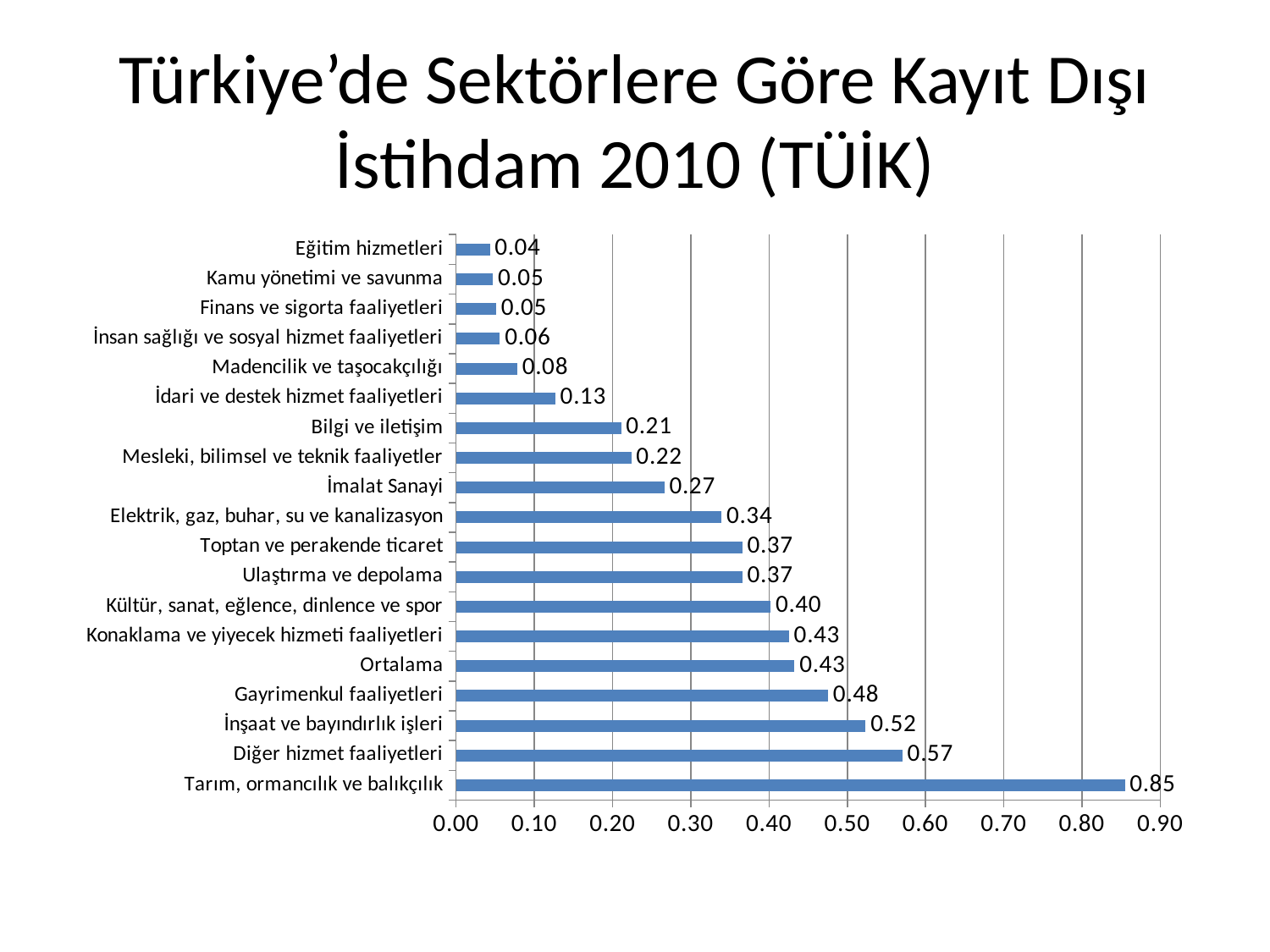
What is the difference between the values for Tarım, ormancılık ve balıkçılık and Diğer hizmet faaliyetleri? 0.28 What is the title of the slide? Türkiye'de Sektörlere Göre Kayıt Dışı İstihdam 2010 (TÜİK) Which category has the lowest value? Eğitim hizmetleri Which category has the highest value? Tarım, ormancılık ve balıkçılık What is the value for Tarım, ormancılık ve balıkçılık? 0.85 What kind of chart is shown on the slide? Bar chart What is the value for Ortalama? 0.43 What is the value for İmalat Sanayi? 0.27 What is the difference between the values for İnşaat ve bayındırlık işleri and Gayrimenkul faaliyetleri? 0.04 How many categories are shown in the chart? 19 What is the value for Madencilik ve taşocakçılığı? 0.08 Which is larger, the value for Bilgi ve iletişim or the value for Elektrik, gaz, buhar, su ve kanalizasyon? Elektrik, gaz, buhar, su ve kanalizasyon